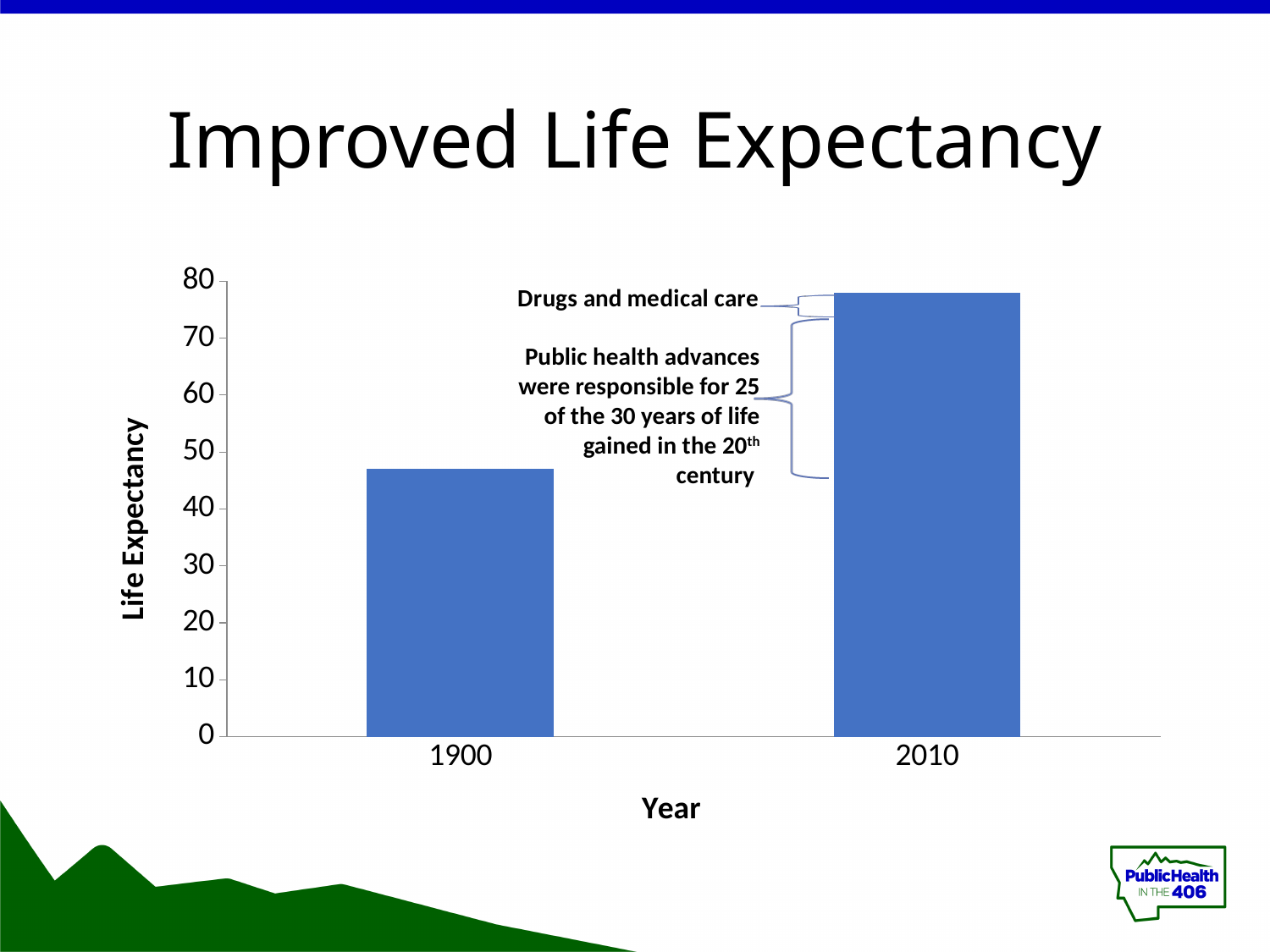
What is the label on the vertical axis of the chart? Life Expectancy Is the life expectancy for 1900 greater or less than 50? less Which year has the lower life expectancy in the chart? 1900 How many bars (years) are plotted in the chart? 2 Which is larger, the life expectancy for 1900 or for 2010? 2010 Which year has the higher life expectancy in the chart? 2010 What is the label on the horizontal axis of the chart? Year What kind of chart is shown on the slide? bar chart Is the life expectancy for 2010 greater or less than 70? greater Does life expectancy rise or fall from 1900 to 2010 in the chart? rise Is the life expectancy for 1900 greater or less than 40? greater